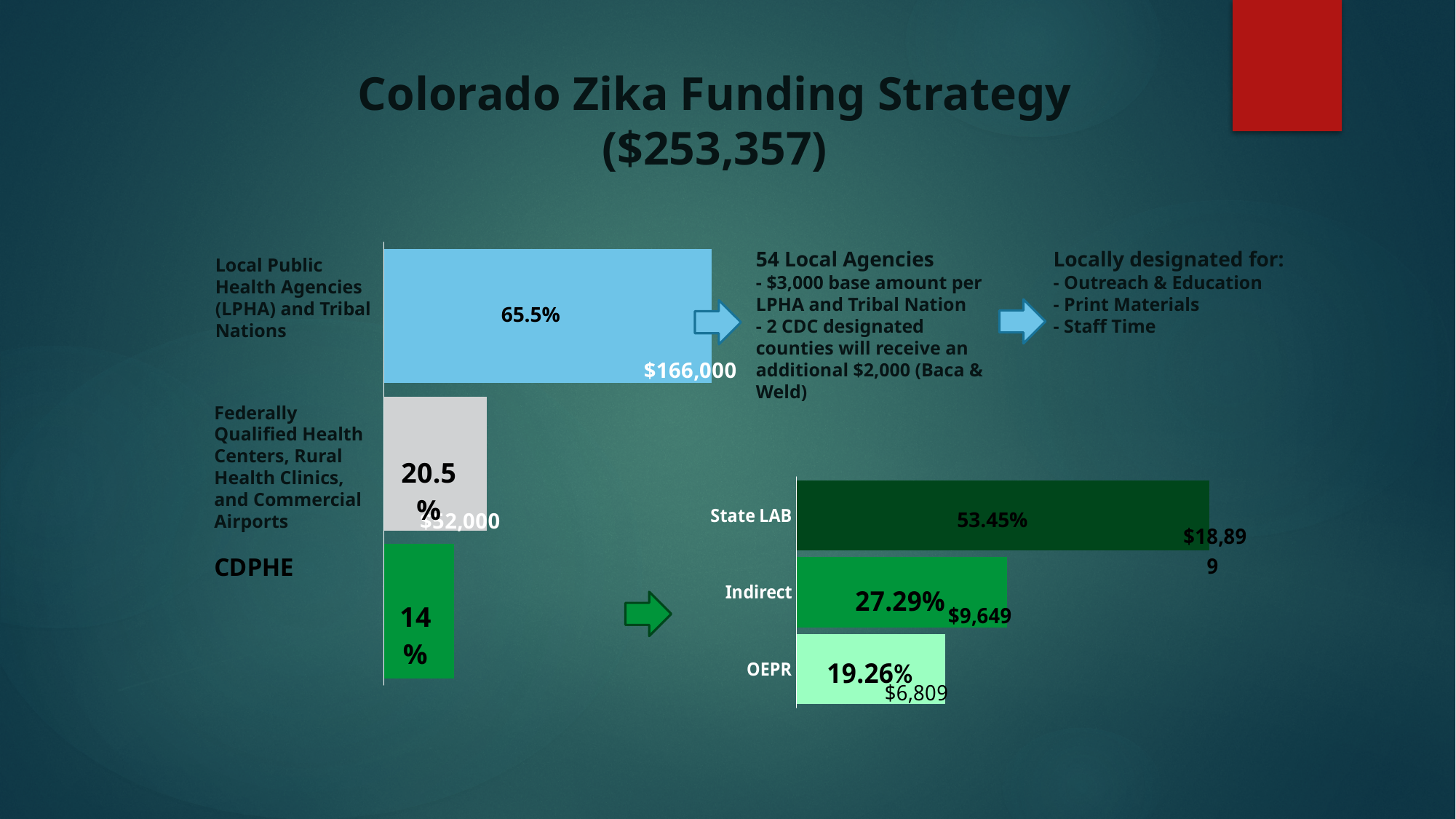
In the right chart, what is the difference in percentage points between State LAB and OEPR? 34.19 In the right chart, what percentage is shown for Indirect? 27.29% In the left chart, what percentage is shown for CDPHE? 14% In the right chart, what dollar amount is labeled on the OEPR bar? $6,809 In the left chart, how many categories are plotted? 3 In the left chart, what dollar amount is labeled on the Local Public Health Agencies (LPHA) and Tribal Nations bar? $166,000 In the right chart, which is larger, Indirect or OEPR? Indirect In the left chart, which category has the smallest share? CDPHE In the left chart, which category has the largest share? Local Public Health Agencies (LPHA) and Tribal Nations In the left chart, what percentage is shown for Local Public Health Agencies (LPHA) and Tribal Nations? 65.5% In the left chart, what percentage is shown for Federally Qualified Health Centers, Rural Health Clinics, and Commercial Airports? 20.5% What type of chart is used on the right side of the slide? Bar chart